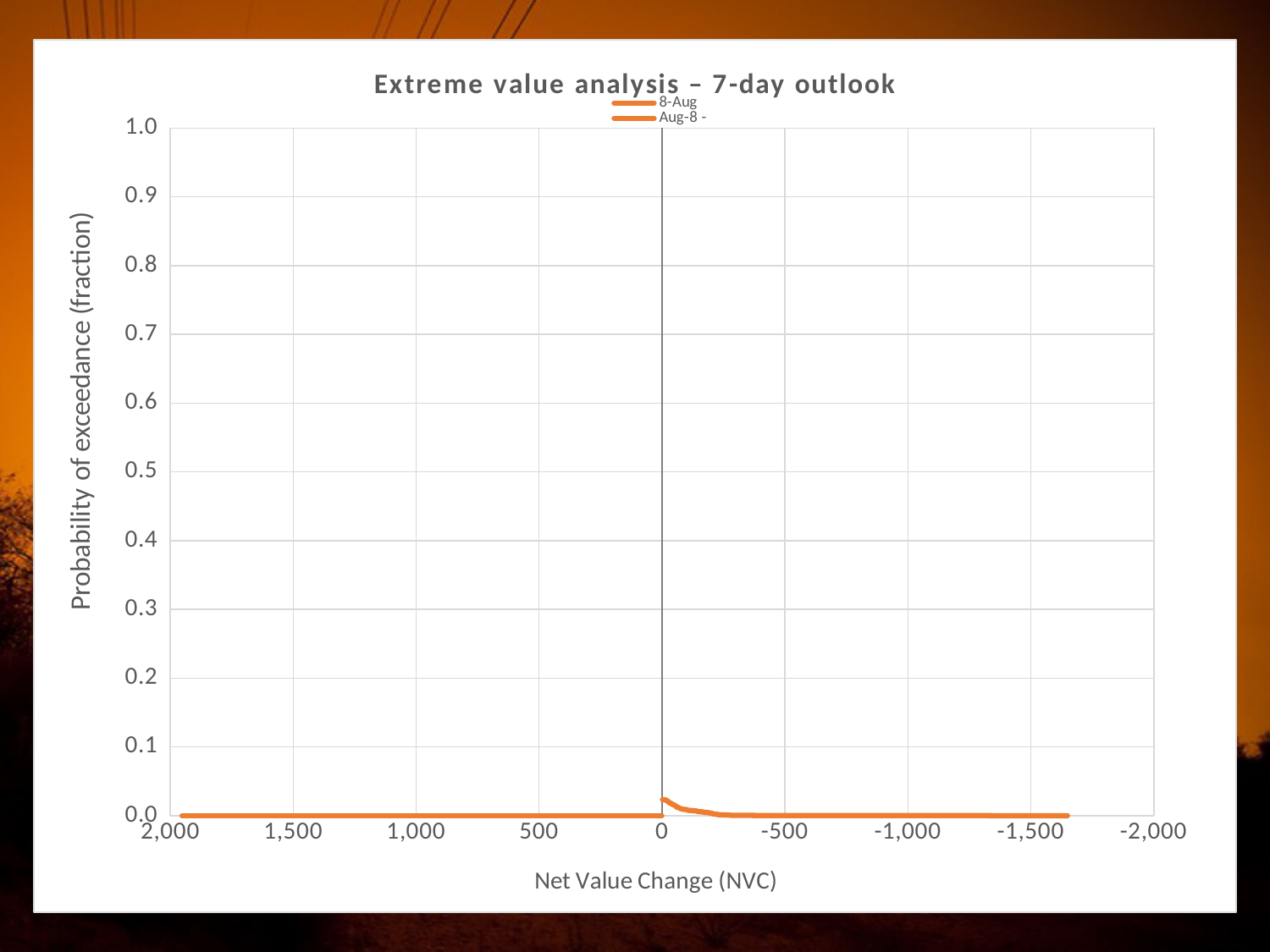
Is the probability of exceedance at a Net Value Change of -1,000 greater or less than 0.2? less Moving from a Net Value Change of 0 to -500, does the plotted line rise or fall? fall What is the title of the chart? Extreme value analysis – 7-day outlook What is the label of the x axis? Net Value Change (NVC) Is the probability of exceedance at a Net Value Change of 0 greater or less than 0.1? less What is the highest value shown on the y axis? 1.0 How many series does the legend list? 2 What is the leftmost value shown on the x axis? 2,000 Is the probability of exceedance at a Net Value Change of 1,000 greater or less than 0.5? less What kind of chart is shown on the slide? line chart